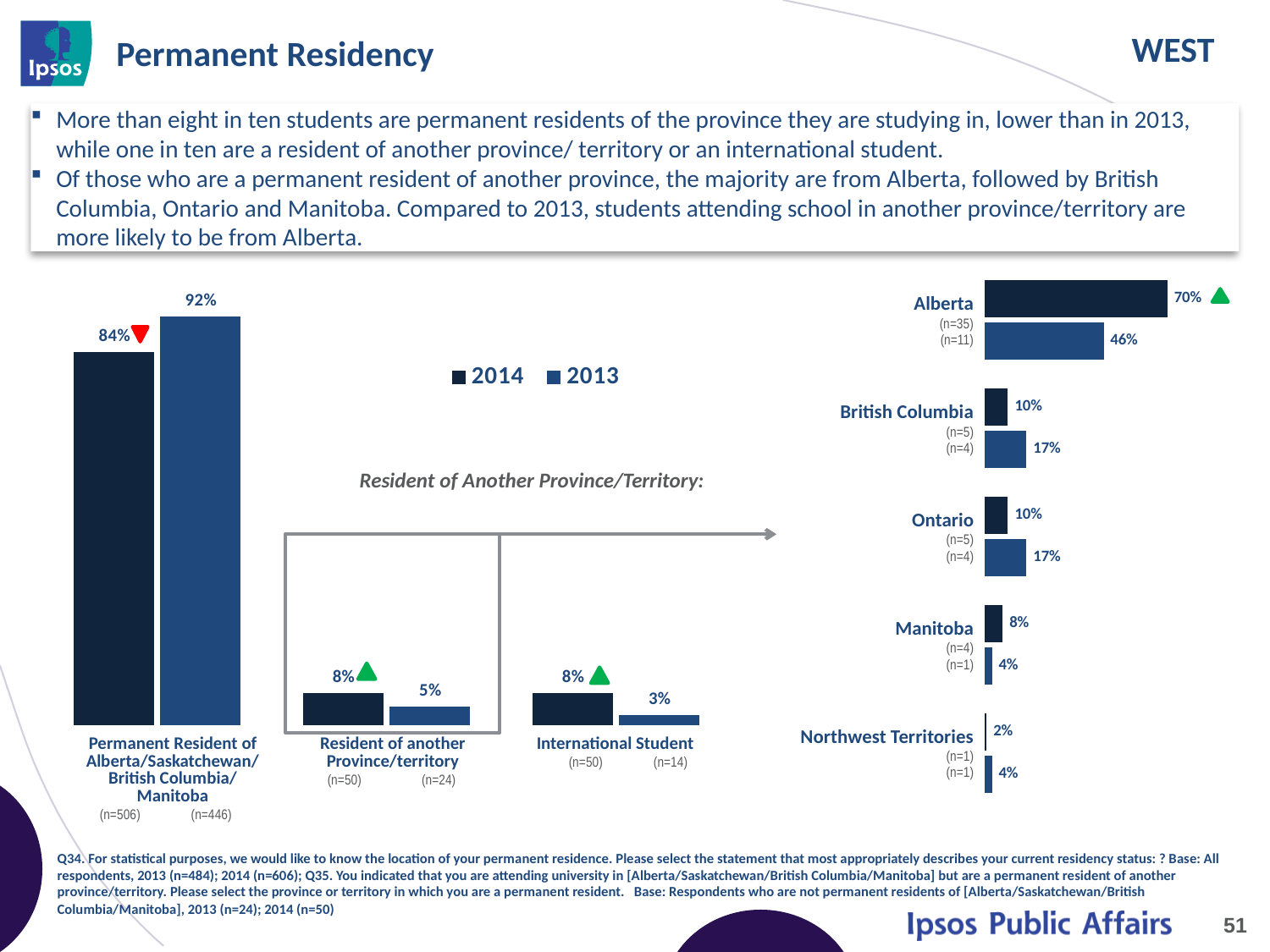
In the right chart (Resident of Another Province/Territory), what is the 2013 value for British Columbia? 17% In the right chart (Resident of Another Province/Territory), what is the 2014 value for Alberta? 70% In the left chart, what is the 2013 value for International Student? 3% What kind of chart is the left chart? Bar chart In the right chart (Resident of Another Province/Territory), what is the difference between the 2014 and 2013 values for Alberta? 24% In the left chart, how many series does the legend list? 2 In the left chart, what is the 2014 value for Permanent Resident of Alberta/Saskatchewan/British Columbia/Manitoba? 84% In the left chart, what is the difference between the 2013 and 2014 values for Permanent Resident of Alberta/Saskatchewan/British Columbia/Manitoba? 8% In the right chart (Resident of Another Province/Territory), is the 2014 value for Manitoba larger or smaller than its 2013 value? Larger In the right chart (Resident of Another Province/Territory), which province or territory has the highest 2014 value? Alberta In the right chart (Resident of Another Province/Territory), which province or territory has the lowest 2014 value? Northwest Territories In the left chart, how many categories are shown? 3